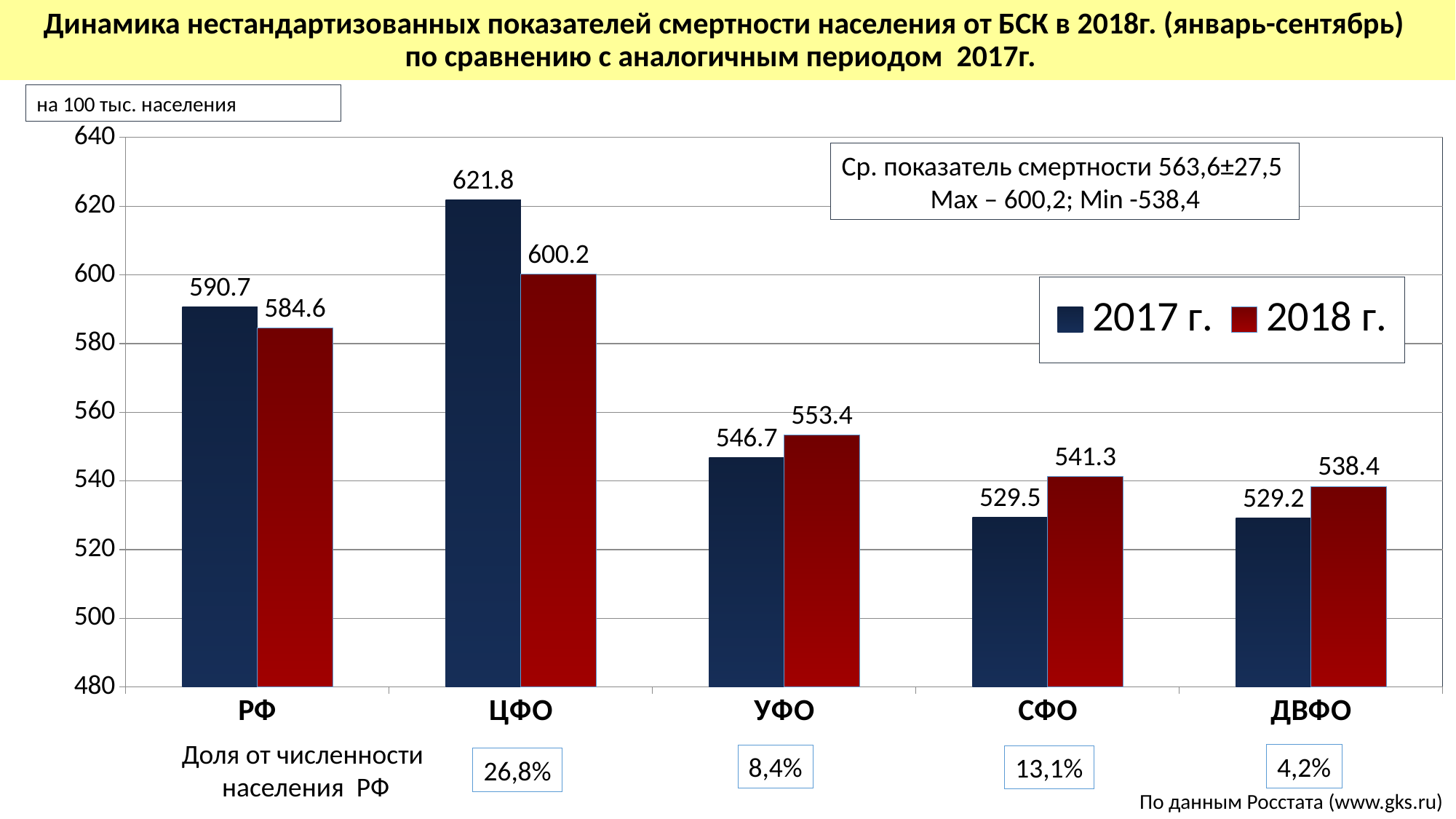
What is the 2018 г. value for УФО? 553.4 Which category has the lowest 2018 г. value? ДВФО What is the 2018 г. value for ДВФО? 538.4 How many series does the legend list? 2 How many categories are shown on the x axis? 5 What kind of chart is shown on the slide? bar chart What unit is stated in the box above the chart? на 100 тыс. населения Which is larger for УФО, the 2017 г. value or the 2018 г. value? 2018 г. What is the difference between the 2017 г. and 2018 г. values for СФО? 11.8 Which category has the highest 2017 г. value? ЦФО What is the difference between the 2017 г. and 2018 г. values for РФ? 6.1 What is the 2017 г. value for ЦФО? 621.8